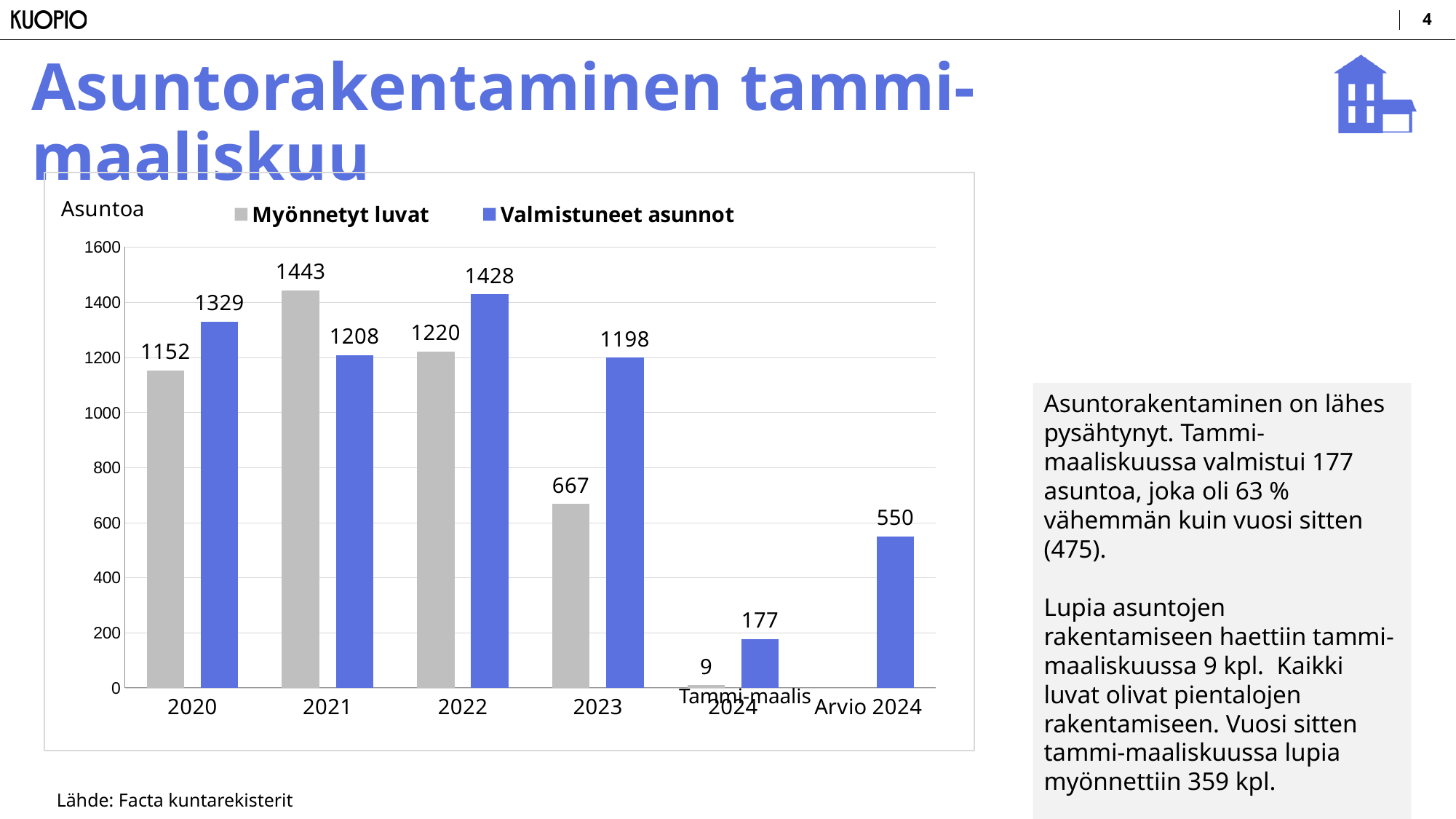
What is the value of Myönnetyt luvat for Tammi-maalis 2024? 9 How many series does the legend list? 2 What is the value of Valmistuneet asunnot for 2022? 1428 Which category has the highest value for Myönnetyt luvat? 2021 What is the value of Myönnetyt luvat for 2021? 1443 What is the value of Valmistuneet asunnot for Arvio 2024? 550 Which category has the lowest value for Valmistuneet asunnot? Tammi-maalis 2024 Which is larger in 2020: Myönnetyt luvat or Valmistuneet asunnot? Valmistuneet asunnot Does the value of Myönnetyt luvat rise or fall from 2021 to 2023? Fall What is the difference between Valmistuneet asunnot and Myönnetyt luvat in 2023? 531 How many categories are shown on the x axis? 6 What type of chart is shown on the slide? Bar chart